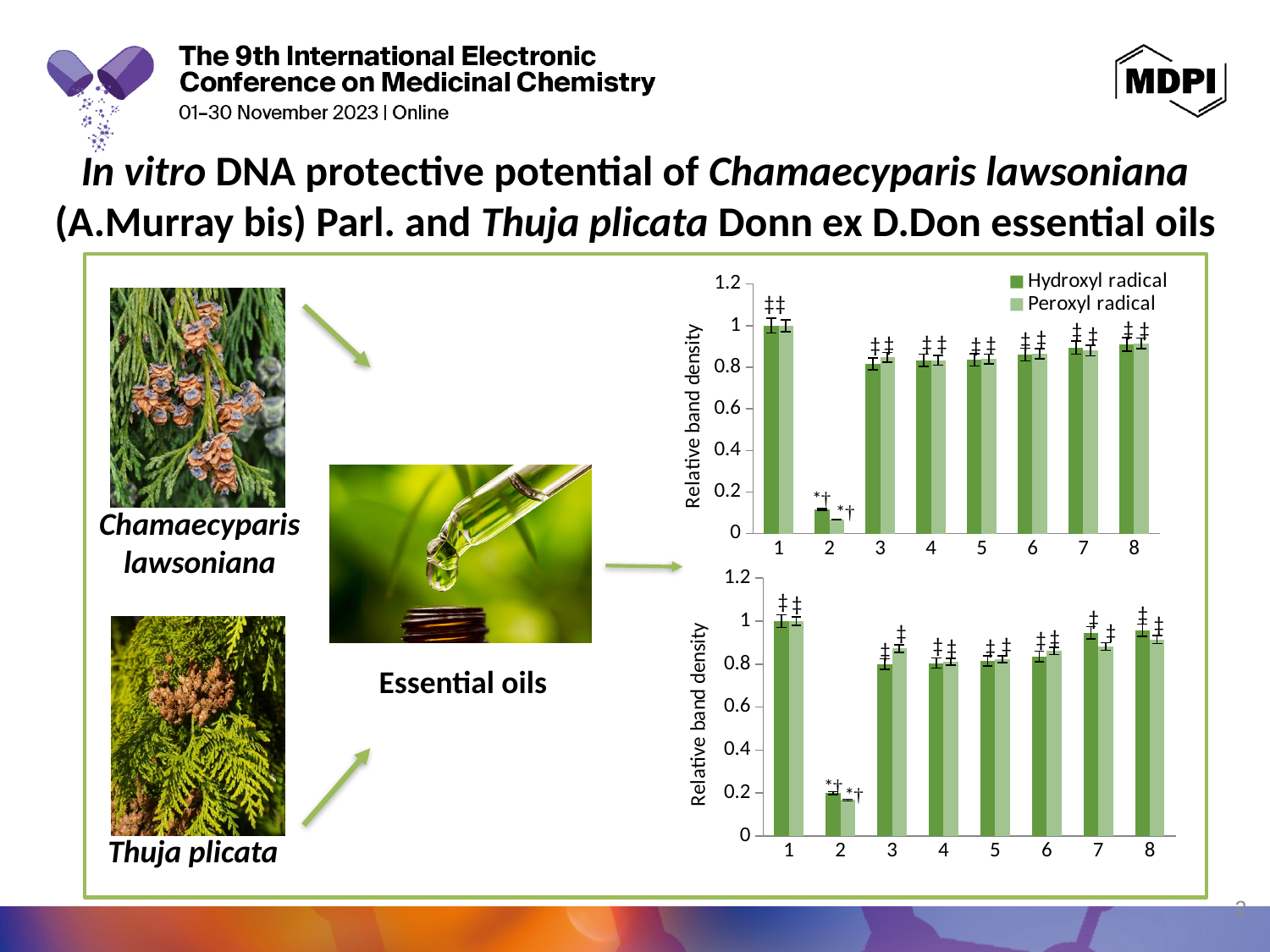
In the bottom chart, which category has the lowest Peroxyl radical value? 2 How many series does the legend of the top chart list? 2 In the top chart, is the Hydroxyl radical value for category 2 greater or less than 0.2? less In the bottom chart, is the Peroxyl radical value for category 2 greater or less than 0.4? less What are the two series named in the legend of the top chart? Hydroxyl radical, Peroxyl radical In the top chart, which category has the lowest Hydroxyl radical value? 2 What is the y-axis label of the bottom chart? Relative band density What kind of chart is the top chart on the right of the slide? bar chart How many categories are shown on the x axis of the bottom chart? 8 In the bottom chart, is the Hydroxyl radical value for category 3 greater or less than 0.6? greater In the bottom chart, which is larger: the Hydroxyl radical value for category 2 or for category 5? category 5 In the top chart, which category has the highest Hydroxyl radical value? 1